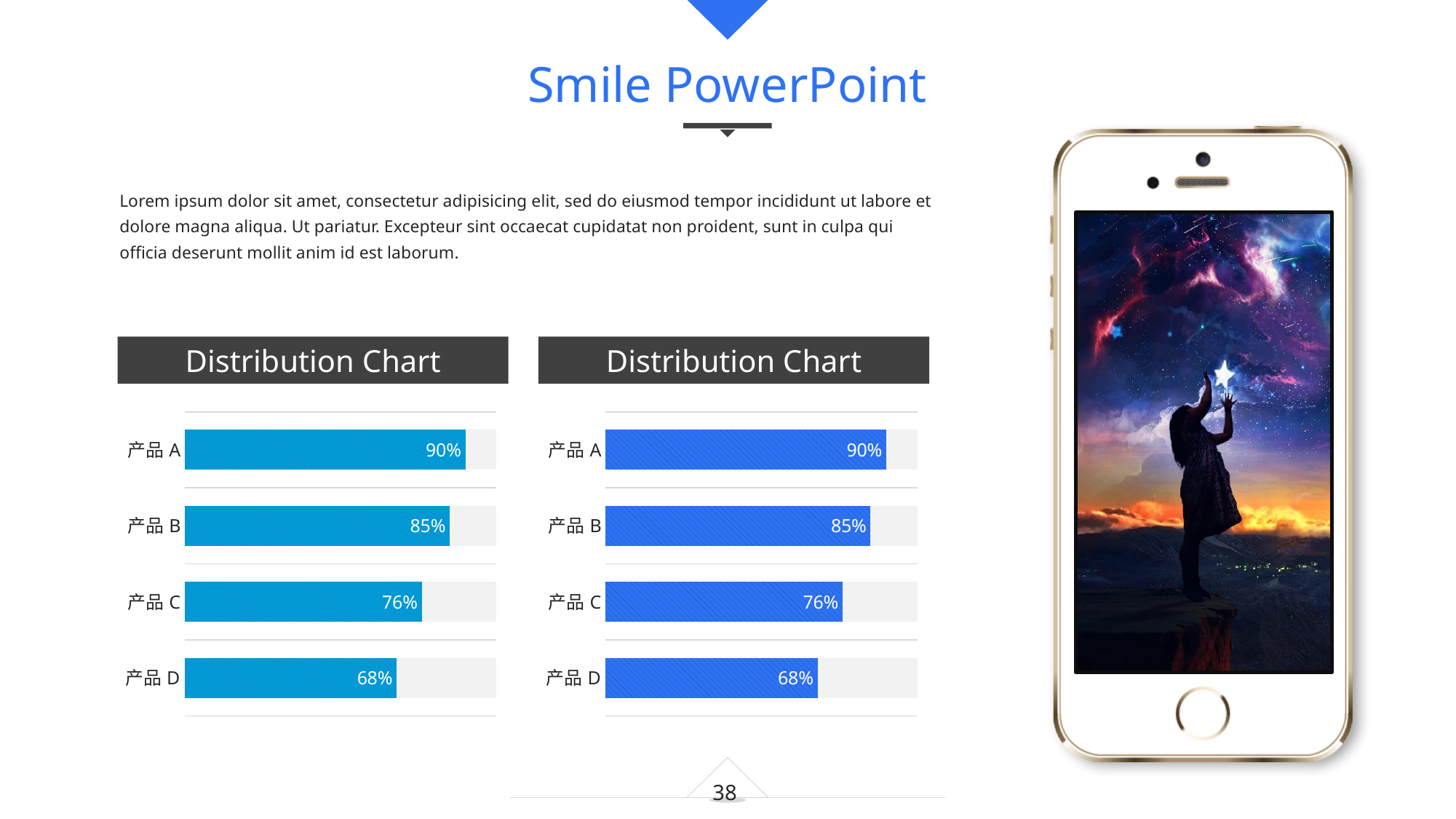
In the right Distribution Chart, what is the difference between the values for 产品 B and 产品 C? 9% In the left Distribution Chart, what is the value for 产品 A? 90% In the right Distribution Chart, what is the value for 产品 B? 85% In the left Distribution Chart, do the values rise or fall from 产品 A to 产品 D? fall In the left Distribution Chart, what is the difference between the values for 产品 A and 产品 D? 22% What kind of chart is the right Distribution Chart? bar chart In the left Distribution Chart, which category has the highest value? 产品 A In the right Distribution Chart, what is the value for 产品 C? 76% In the left Distribution Chart, what is the value for 产品 D? 68% How many categories does the left Distribution Chart show? 4 In the right Distribution Chart, which category has the lowest value? 产品 D In the right Distribution Chart, which is larger, the value for 产品 B or the value for 产品 C? 产品 B